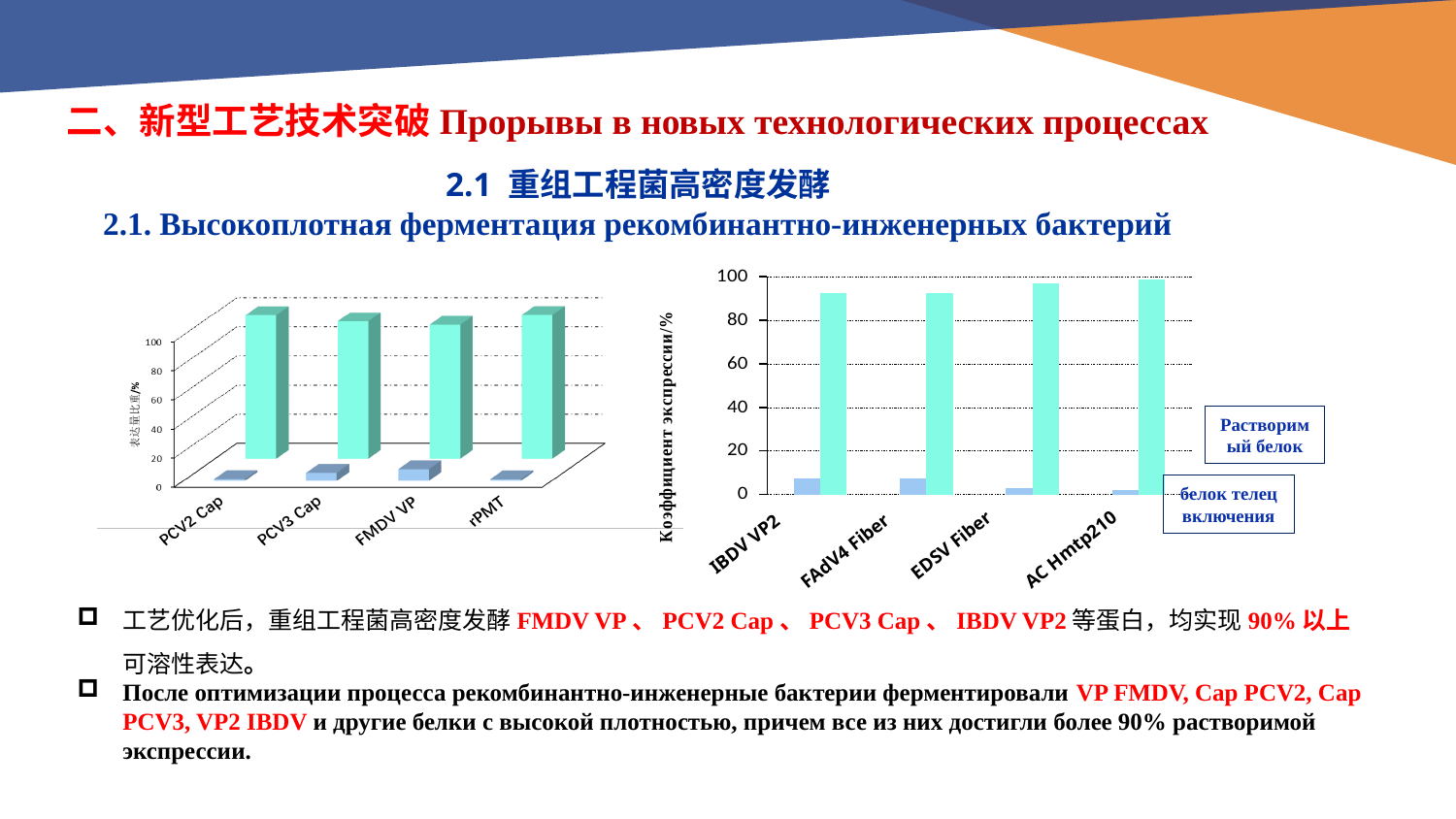
In the right-hand chart, which is larger for белок телец включения: IBDV VP2 or AC Hmtp210? IBDV VP2 How many categories are shown on the x axis of the right-hand chart? 4 In the right-hand chart, is the value of белок телец включения for IBDV VP2 greater or less than 20? less In the right-hand chart, is the value of Растворимый белок for IBDV VP2 greater or less than 80? greater What kind of chart is the right-hand chart with the y-axis labelled Коэффициент экспрессии/%? bar chart In the right-hand chart, is the value of Растворимый белок for AC Hmtp210 greater or less than 80? greater How many categories are shown on the x axis of the left-hand 3D chart? 4 How many series does the legend of the right-hand chart list? 2 What is the y-axis label of the right-hand chart? Коэффициент экспрессии/% In the right-hand chart, which is larger for FAdV4 Fiber: Растворимый белок or белок телец включения? Растворимый белок In the right-hand chart, which series does the legend entry 'Растворимый белок' correspond to, the tall bars or the short bars? the tall bars